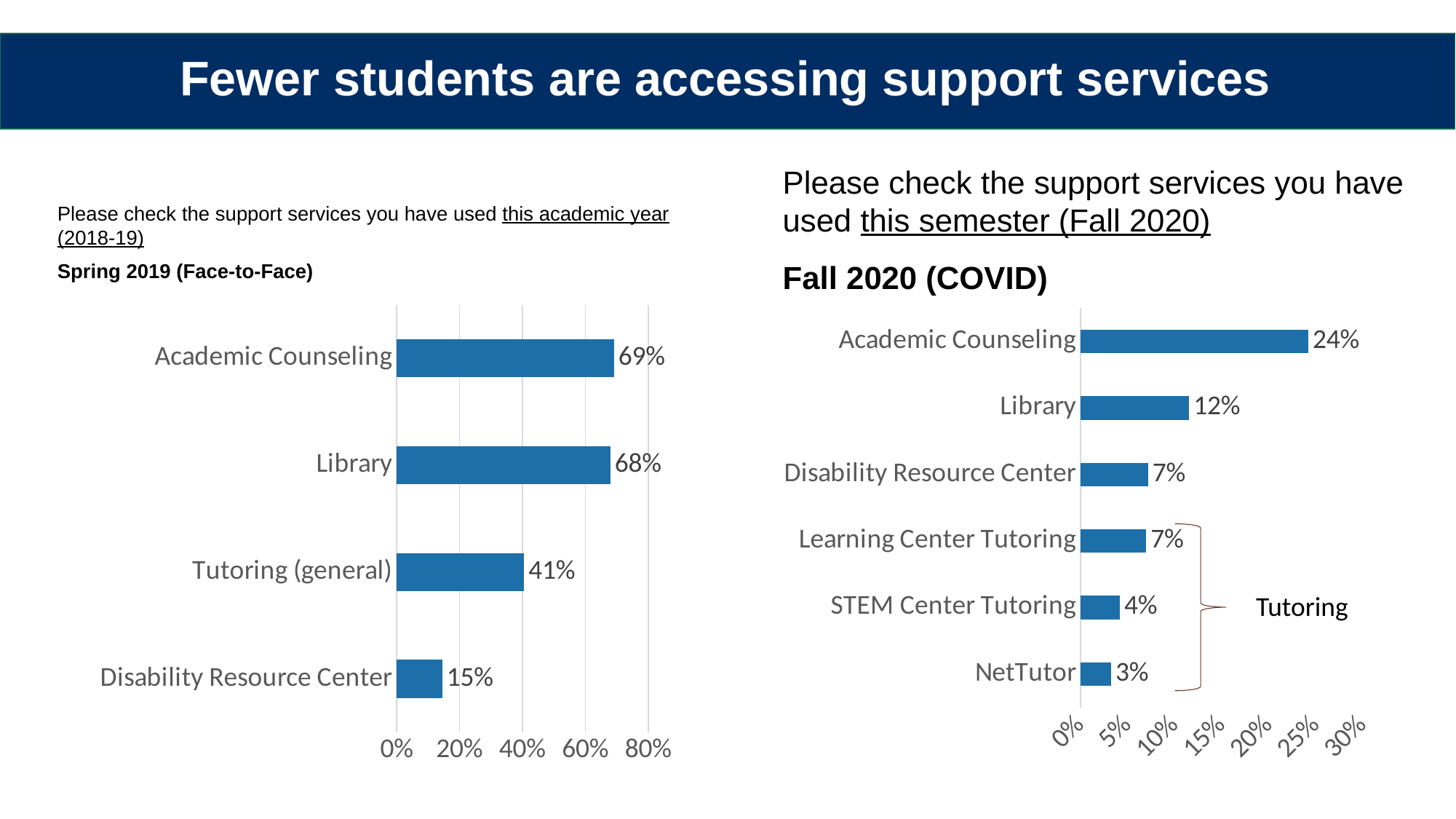
In the Fall 2020 (COVID) chart, which three categories are grouped by the bracket labelled Tutoring? Learning Center Tutoring, STEM Center Tutoring, NetTutor In the Spring 2019 (Face-to-Face) chart, what percentage of students used Academic Counseling? 69% In the Spring 2019 (Face-to-Face) chart, what is the difference between the Tutoring (general) value and the Disability Resource Center value? 26% In the Fall 2020 (COVID) chart, which service has the lowest value? NetTutor How many categories are shown in the Fall 2020 (COVID) chart? 6 In the Spring 2019 (Face-to-Face) chart, which service has the lowest value? Disability Resource Center In the Fall 2020 (COVID) chart, which service has the highest value? Academic Counseling In the Fall 2020 (COVID) chart, what percentage of students used the Library? 12% In the Fall 2020 (COVID) chart, which is larger: STEM Center Tutoring or NetTutor? STEM Center Tutoring What type of chart is the Fall 2020 (COVID) chart? Bar chart In the Fall 2020 (COVID) chart, what is the difference between Academic Counseling and Library? 12% How many categories are shown in the Spring 2019 (Face-to-Face) chart? 4